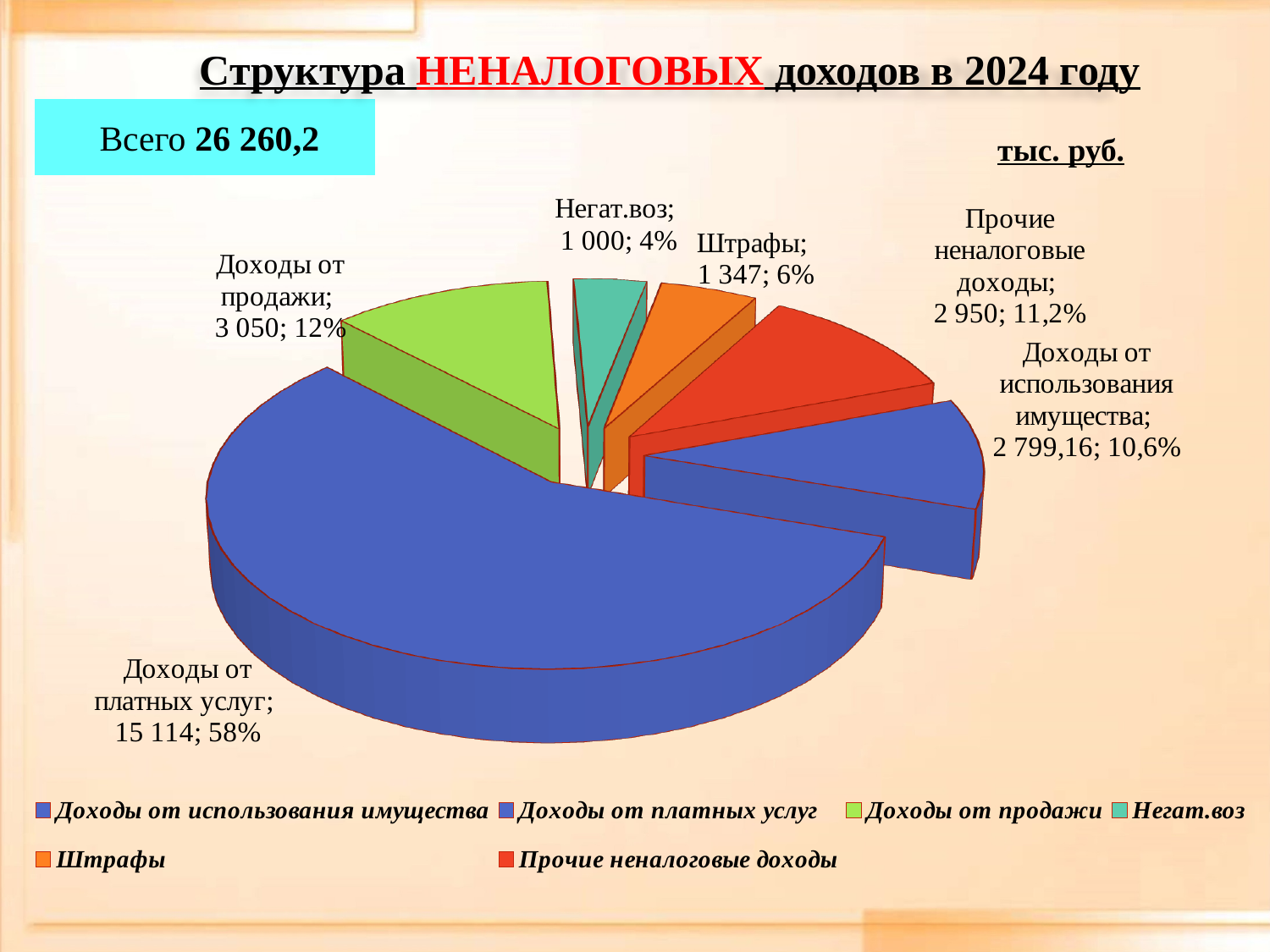
What share of the pie does Негат.воз represent? 4% What is the difference between the values for Доходы от продажи and Штрафы? 1 703 What share of the pie does Прочие неналоговые доходы represent? 11,2% What is the value for Доходы от использования имущества? 2 799,16 What total is stated on the slide for non-tax revenues in 2024? 26 260,2 Which category has the smallest slice of the pie? Негат.воз What type of chart is shown on the slide? Pie chart How many slices does the pie chart have? 6 What is the value for Доходы от платных услуг? 15 114 What is the value for Штрафы? 1 347 Which category has the largest slice of the pie? Доходы от платных услуг Which is larger: Доходы от продажи or Прочие неналоговые доходы? Доходы от продажи